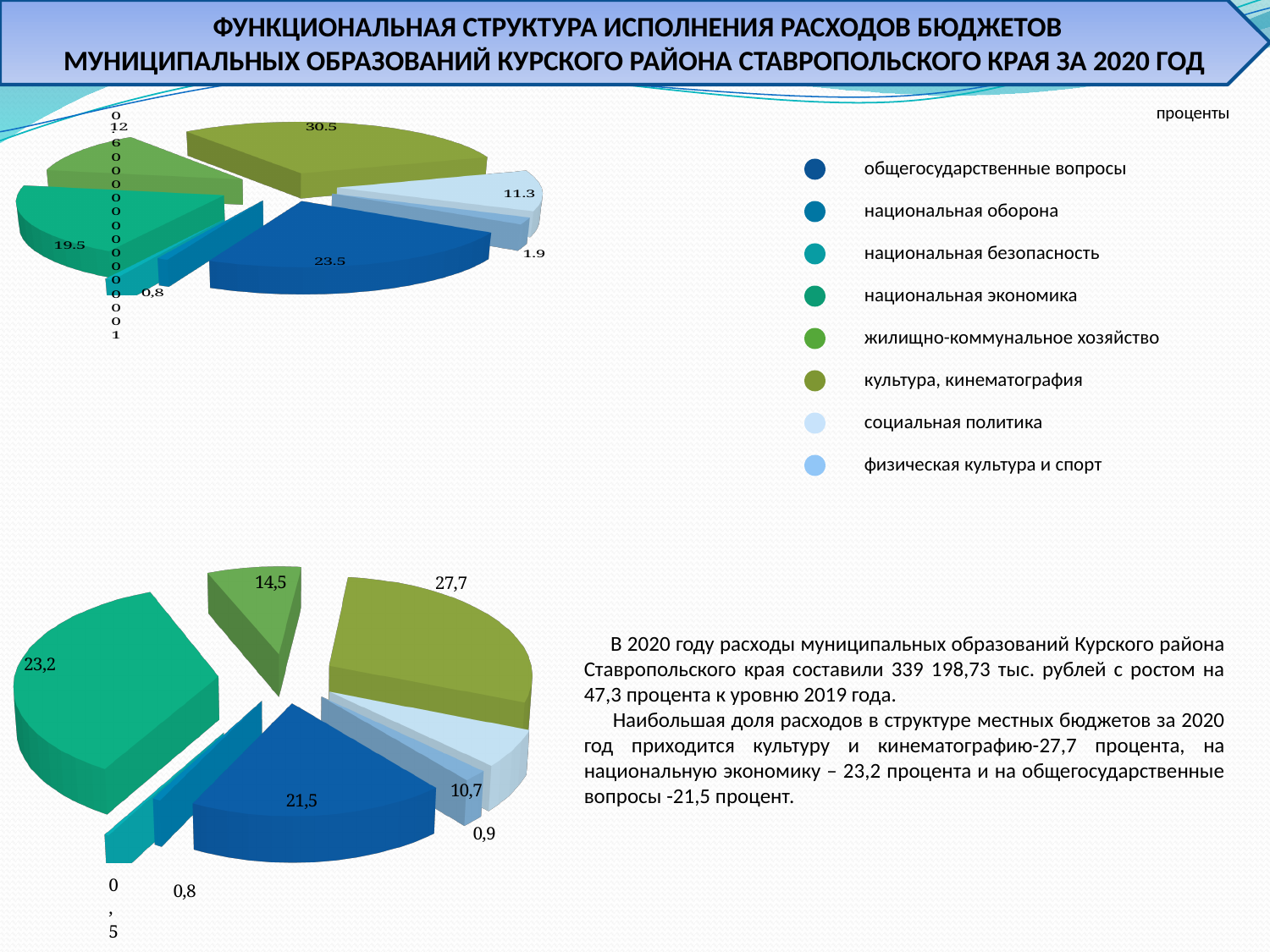
In the top chart, what is the value for общегосударственные вопросы? 23.5 In the top chart, what is the difference between культура, кинематография and общегосударственные вопросы? 7 What kind of chart is the top chart on the slide? pie chart In the top chart, what is the value for социальная политика? 11.3 In the bottom chart, what is the value for культура, кинематография? 27,7 In the bottom chart, which is larger: общегосударственные вопросы or социальная политика? общегосударственные вопросы In the top chart, what is the value for культура, кинематография? 30.5 How many categories does the legend list? 8 In the bottom chart, what is the value for национальная экономика? 23,2 In the top chart, which category has the largest slice? культура, кинематография In the bottom chart, what is the difference between культура, кинематография and национальная экономика? 4,5 In the bottom chart, what is the value for жилищно-коммунальное хозяйство? 14,5